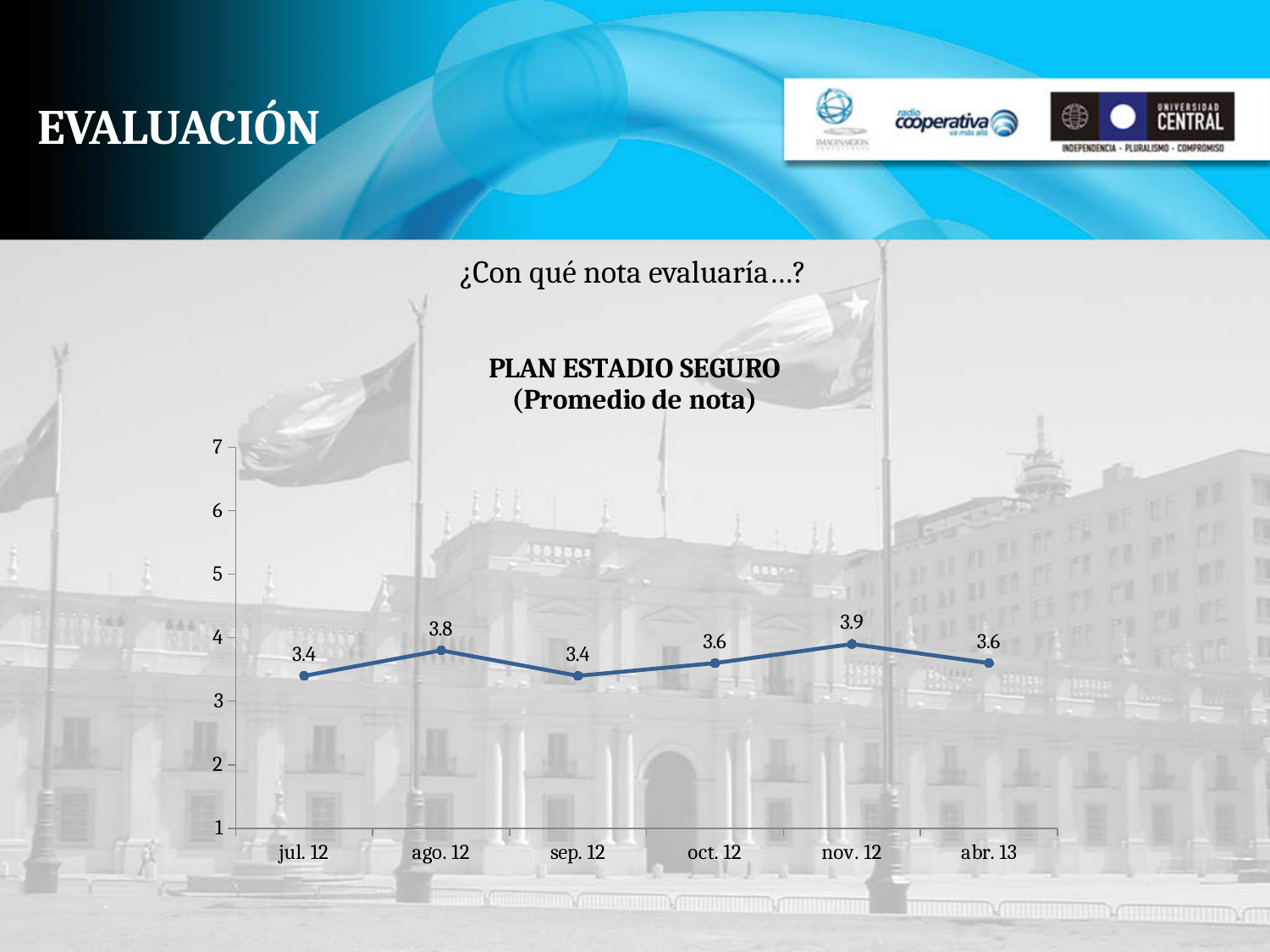
What is the value for ago. 12? 3.8 How many periods are plotted on the x axis? 6 Which is larger, the value for ago. 12 or the value for oct. 12? ago. 12 What is the difference between the values for nov. 12 and sep. 12? 0.5 Is the value for jul. 12 greater or less than 4? less Does the value rise or fall from oct. 12 to nov. 12? rise What is the value for abr. 13? 3.6 What is the value for nov. 12? 3.9 What is the title of the chart? PLAN ESTADIO SEGURO (Promedio de nota) What is the highest value shown on the y axis? 7 What kind of chart is shown? line chart Which period has the highest value? nov. 12